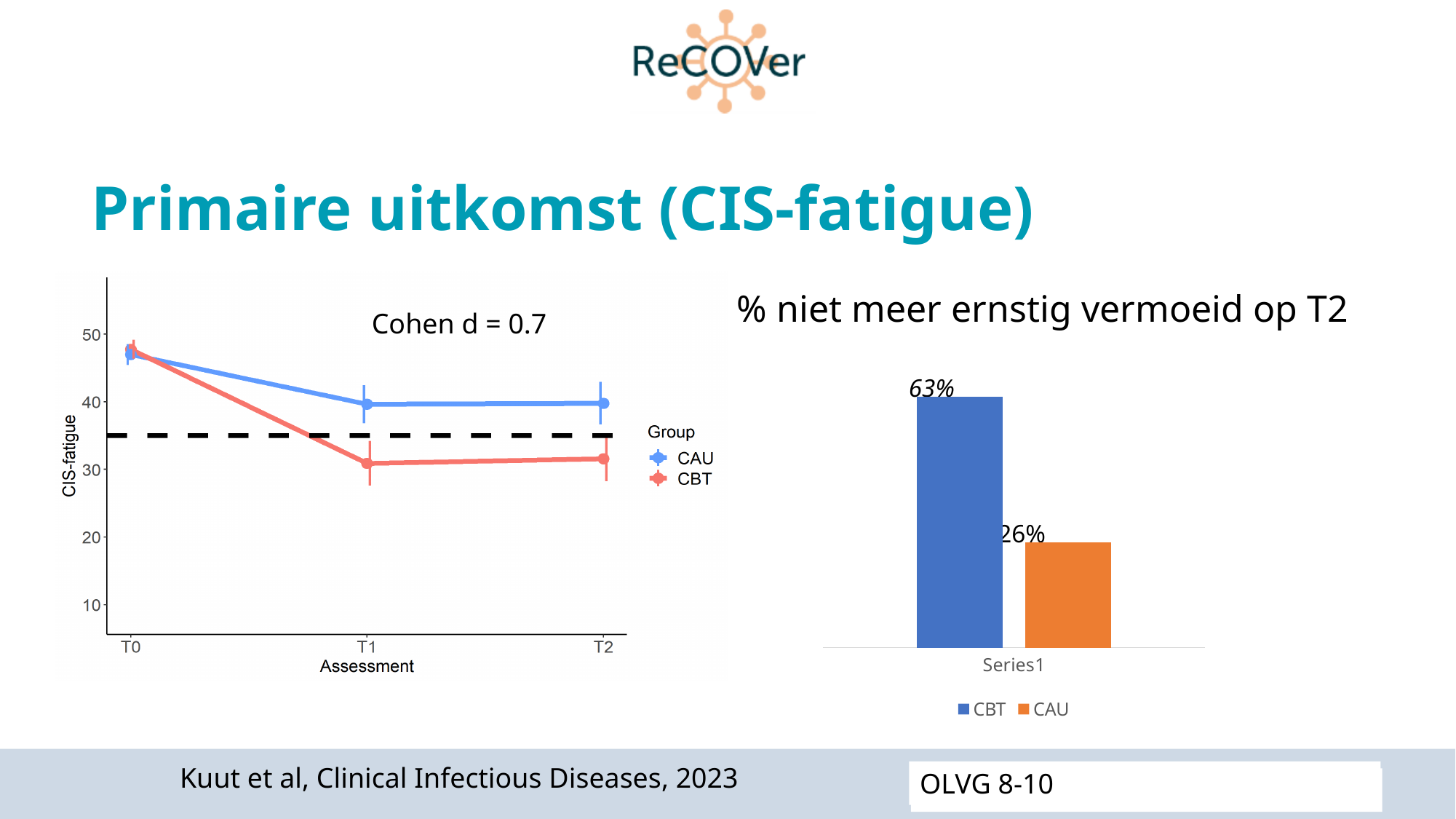
What kind of chart is shown on the right side of the slide? Bar chart In the bar chart titled '% niet meer ernstig vermoeid op T2', what is the value for CBT? 63% In the line chart on the left, which group has the lower CIS-fatigue score at T2? CBT In the line chart on the left, how many groups does the legend list? 2 In the bar chart on the right, how many series does the legend list? 2 In the bar chart on the right, what is the difference between the CBT and CAU percentages? 37% In the line chart on the left, do the CIS-fatigue values for CBT rise or fall from T0 to T1? fall In the line chart on the left, how many assessment points are shown on the x axis? 3 What kind of chart is shown on the left side of the slide? Line chart In the line chart on the left, is the CIS-fatigue value for CBT at T1 greater or less than 40? less In the bar chart titled '% niet meer ernstig vermoeid op T2', what is the value for CAU? 26% In the bar chart on the right, which group has the higher percentage? CBT